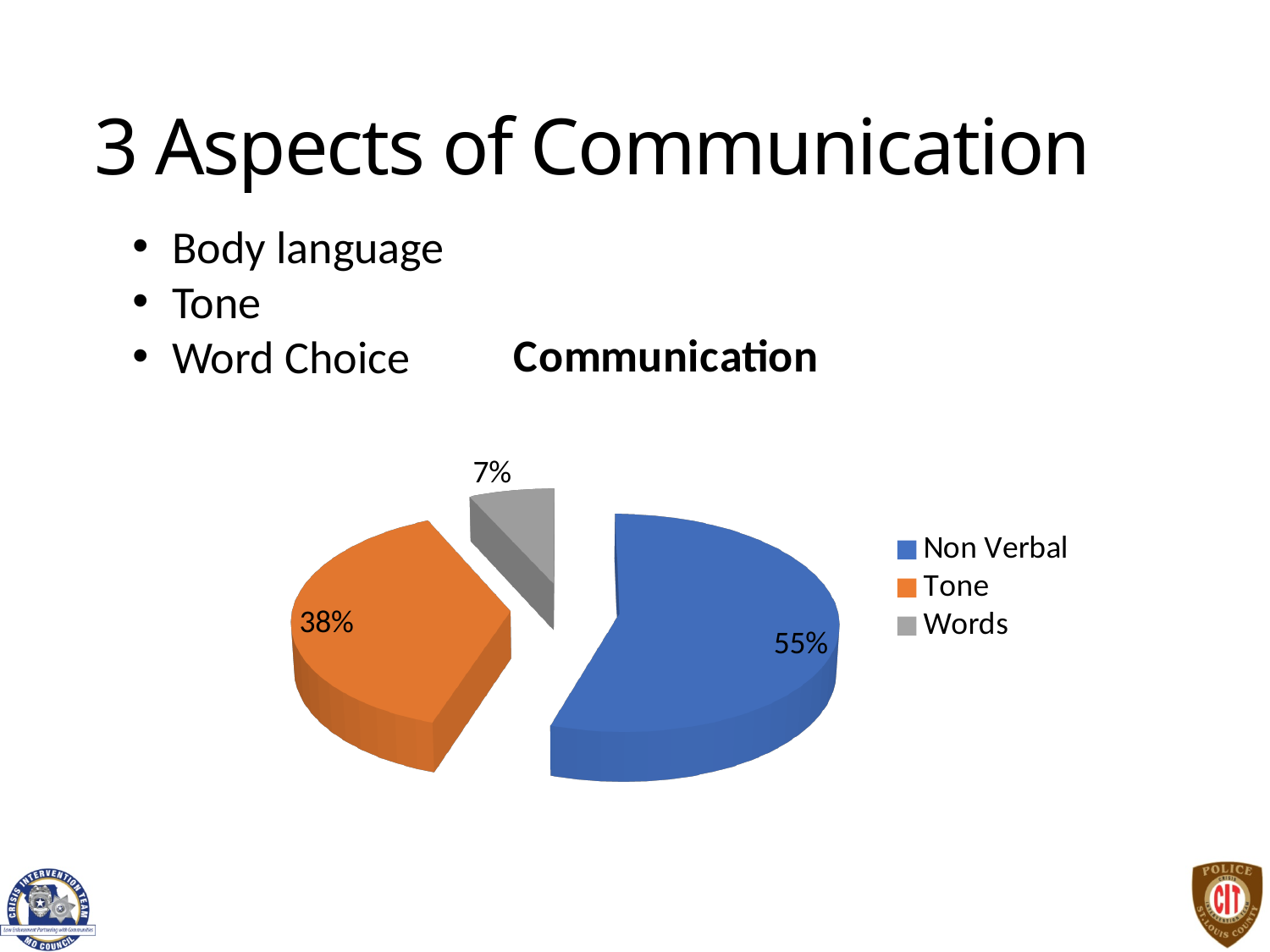
What share of the pie does Non Verbal account for? 55% Which category has the largest slice of the pie? Non Verbal Which category has the smallest slice of the pie? Words What is the title of the chart? Communication How many slices does the pie chart have? 3 What is the difference in percentage points between Non Verbal and Tone? 17 What kind of chart is shown on the slide? Pie chart What share of the pie does Words account for? 7% What is the difference in percentage points between Tone and Words? 31 Which colour represents Tone in the pie chart? Orange Which is larger, the share for Tone or the share for Words? Tone What share of the pie does Tone account for? 38%